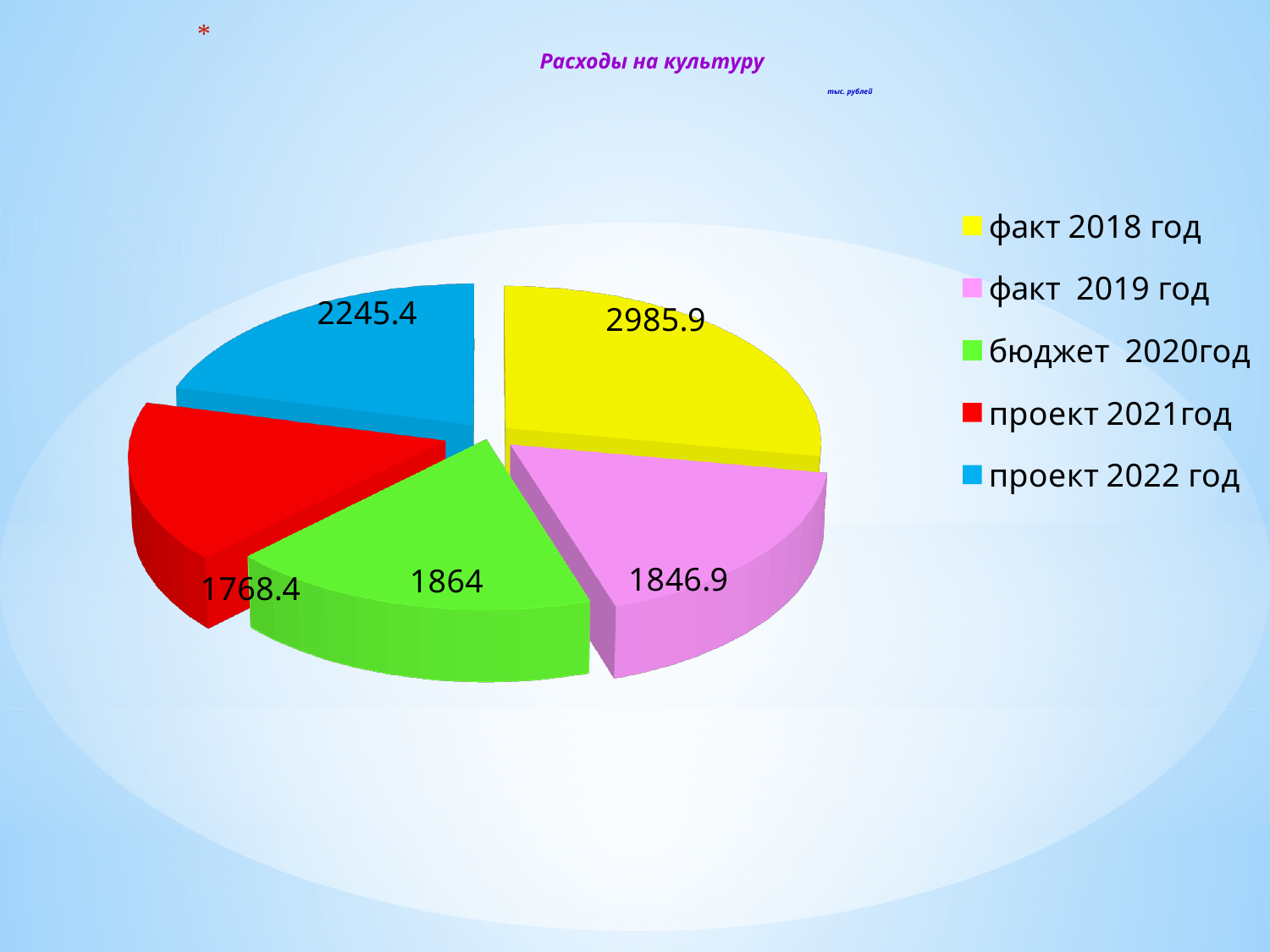
What is the difference between the values for проект 2022 год and проект 2021год? 477 Which category has the largest slice? факт 2018 год What is the value for проект 2022 год? 2245.4 Which is larger, the value for бюджет 2020год or the value for факт 2019 год? бюджет 2020год What type of chart is shown on the slide? pie chart What is the value for бюджет 2020год? 1864 Which category has the smallest slice? проект 2021год Which colour represents проект 2021год in the legend? red What is the title of the chart? Расходы на культуру What is the difference between the values for факт 2018 год and факт 2019 год? 1139 How many slices does the pie chart have? 5 What is the value for факт 2018 год? 2985.9